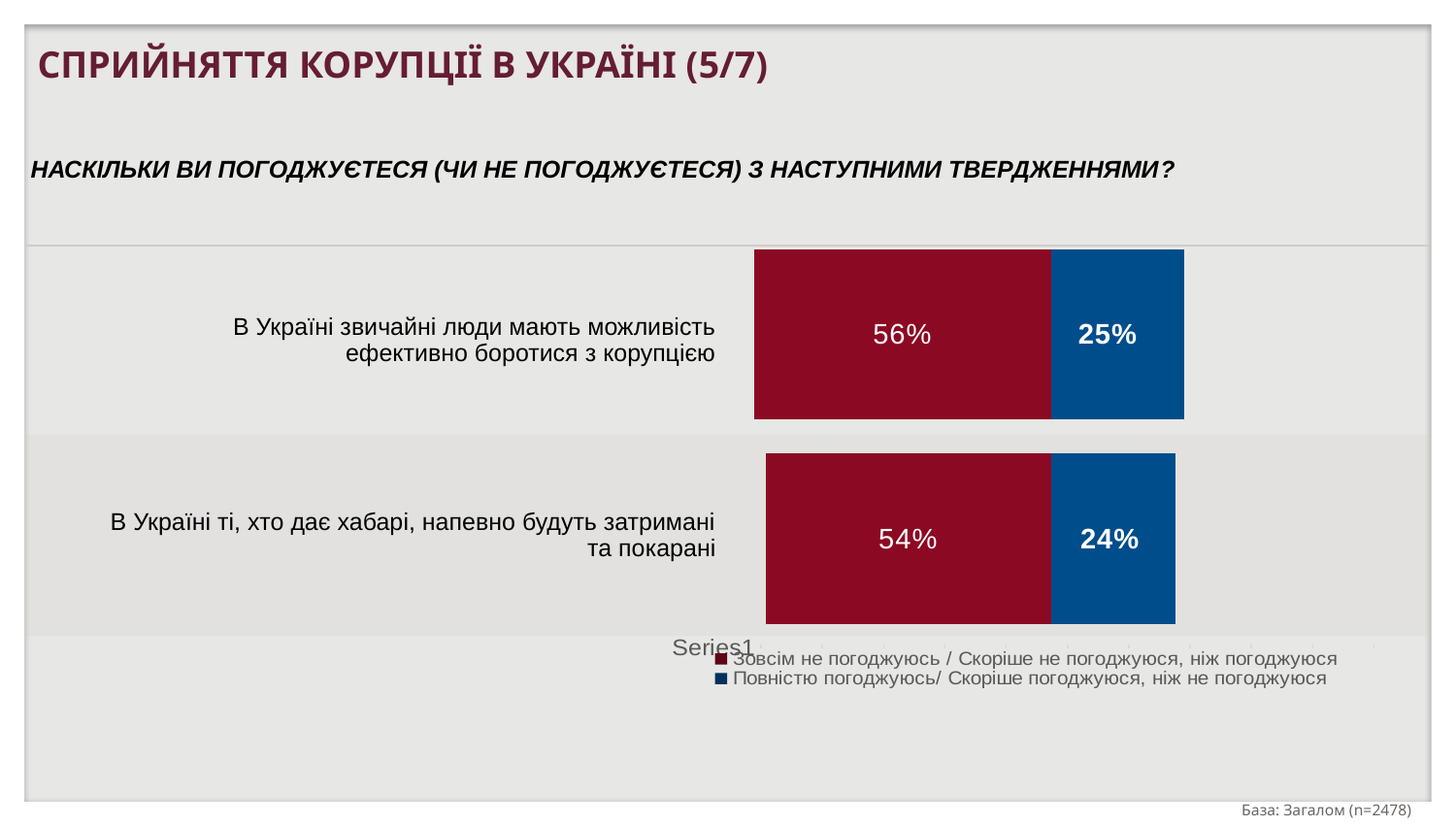
What type of chart is shown on the slide? Stacked horizontal bar chart How many series does the chart legend list? 2 What share of respondents disagree with the statement "В Україні ті, хто дає хабарі, напевно будуть затримані та покарані"? 54% Which statement has the higher share of respondents who disagree? В Україні звичайні люди мають можливість ефективно боротися з корупцією For the statement "В Україні звичайні люди мають можливість ефективно боротися з корупцією", what is the difference in percentage points between the share who disagree and the share who agree? 31 percentage points What share of respondents agree with the statement "В Україні ті, хто дає хабарі, напевно будуть затримані та покарані"? 24% Which statement has the lower share of respondents who agree? В Україні ті, хто дає хабарі, напевно будуть затримані та покарані What share of respondents agree ("Повністю погоджуюсь/ Скоріше погоджуюся, ніж не погоджуюся") with the statement "В Україні звичайні люди мають можливість ефективно боротися з корупцією"? 25% What is the combined share of respondents who disagree or agree with the statement "В Україні звичайні люди мають можливість ефективно боротися з корупцією"? 81% What is the combined share of respondents who disagree or agree with the statement "В Україні ті, хто дає хабарі, напевно будуть затримані та покарані"? 78% How many statements are shown in the chart? 2 What share of respondents disagree ("Зовсім не погоджуюсь / Скоріше не погоджуюся, ніж погоджуюся") with the statement "В Україні звичайні люди мають можливість ефективно боротися з корупцією"? 56%